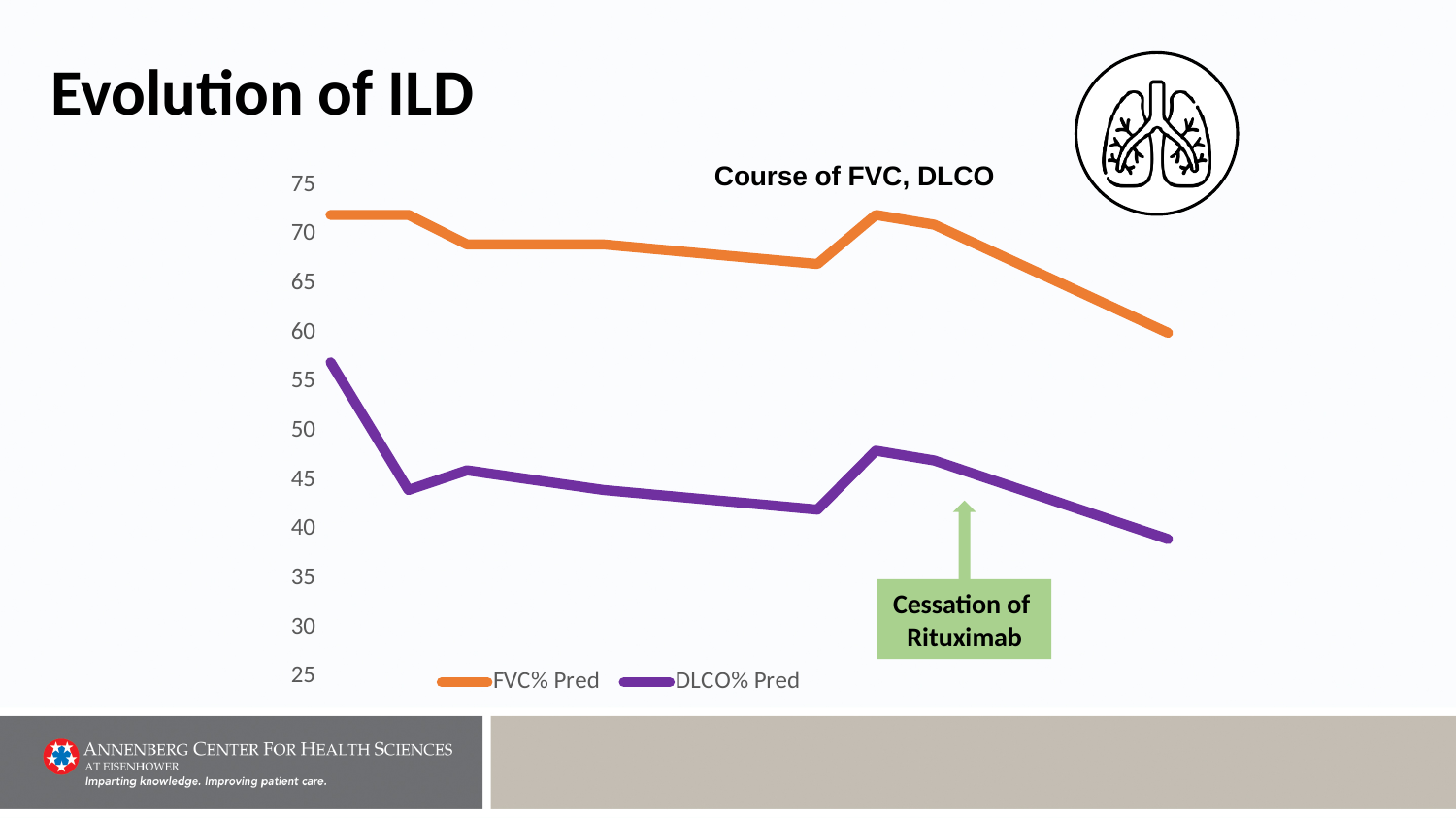
Which series is plotted in purple? DLCO% Pred Does the DLCO% Pred line end higher or lower than it starts? lower Is the first value of the FVC% Pred line greater or less than 70? greater How many series does the legend list? 2 Does the FVC% Pred line end higher or lower than it starts? lower What is the title of the chart? Course of FVC, DLCO Is the last value of the FVC% Pred line greater or less than 65? less Which series has higher values throughout the chart, FVC% Pred or DLCO% Pred? FVC% Pred What kind of chart is shown on the slide? line chart Is the first value of the DLCO% Pred line greater or less than 55? greater